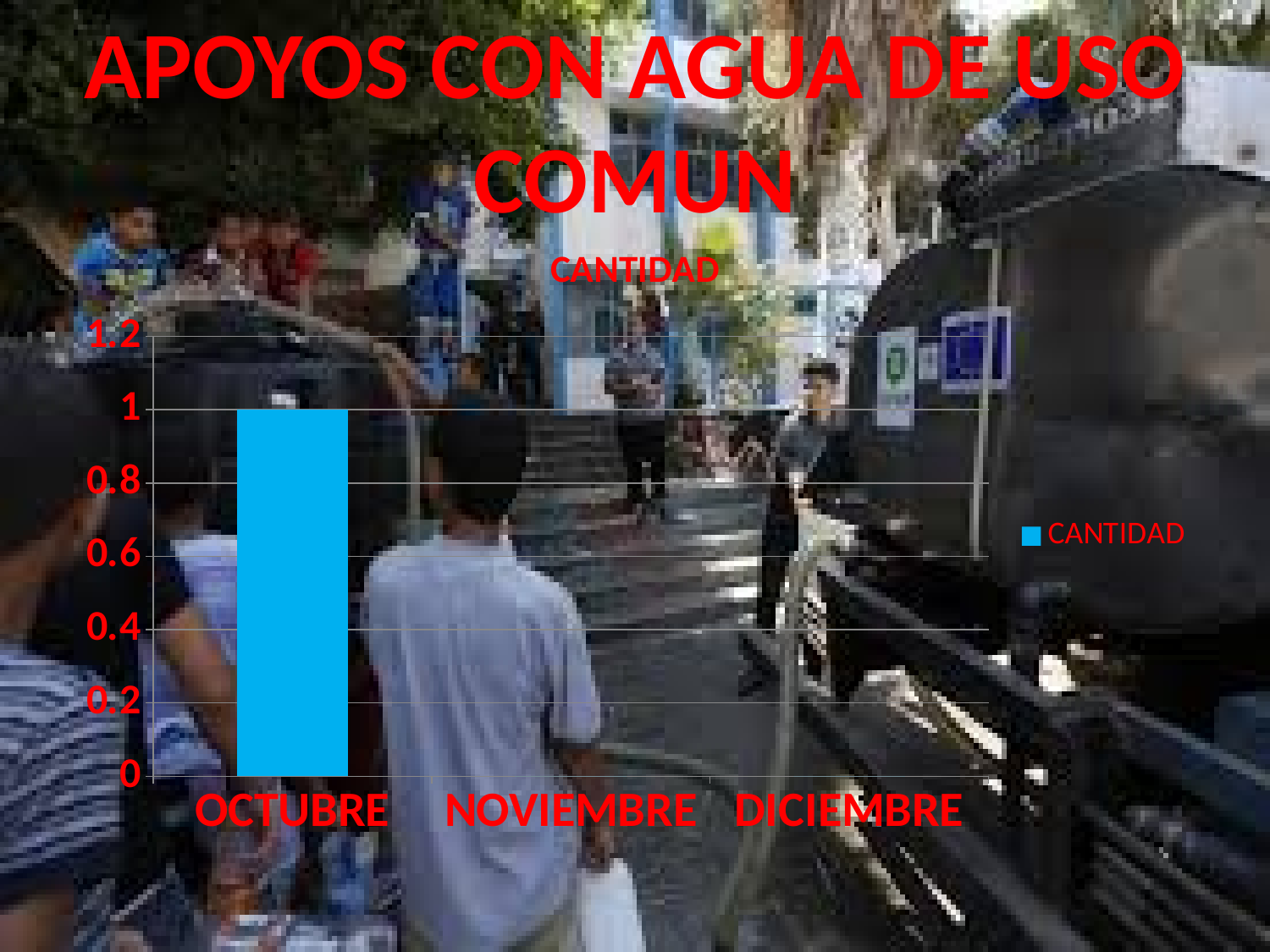
What is the name of the series listed in the chart legend? CANTIDAD How many categories are shown on the x axis of the chart? 3 Which is larger, the value for OCTUBRE or the value for NOVIEMBRE? OCTUBRE What is the title of the chart? CANTIDAD What is the highest value labelled on the vertical axis of the chart? 1.2 What kind of chart is shown on the slide? bar chart What is the value for OCTUBRE in the chart? 1 Is the value for OCTUBRE greater or less than 1.2? less How many series does the chart legend list? 1 Is the value for OCTUBRE greater or less than 0.8? greater Which category has the highest value in the chart? OCTUBRE